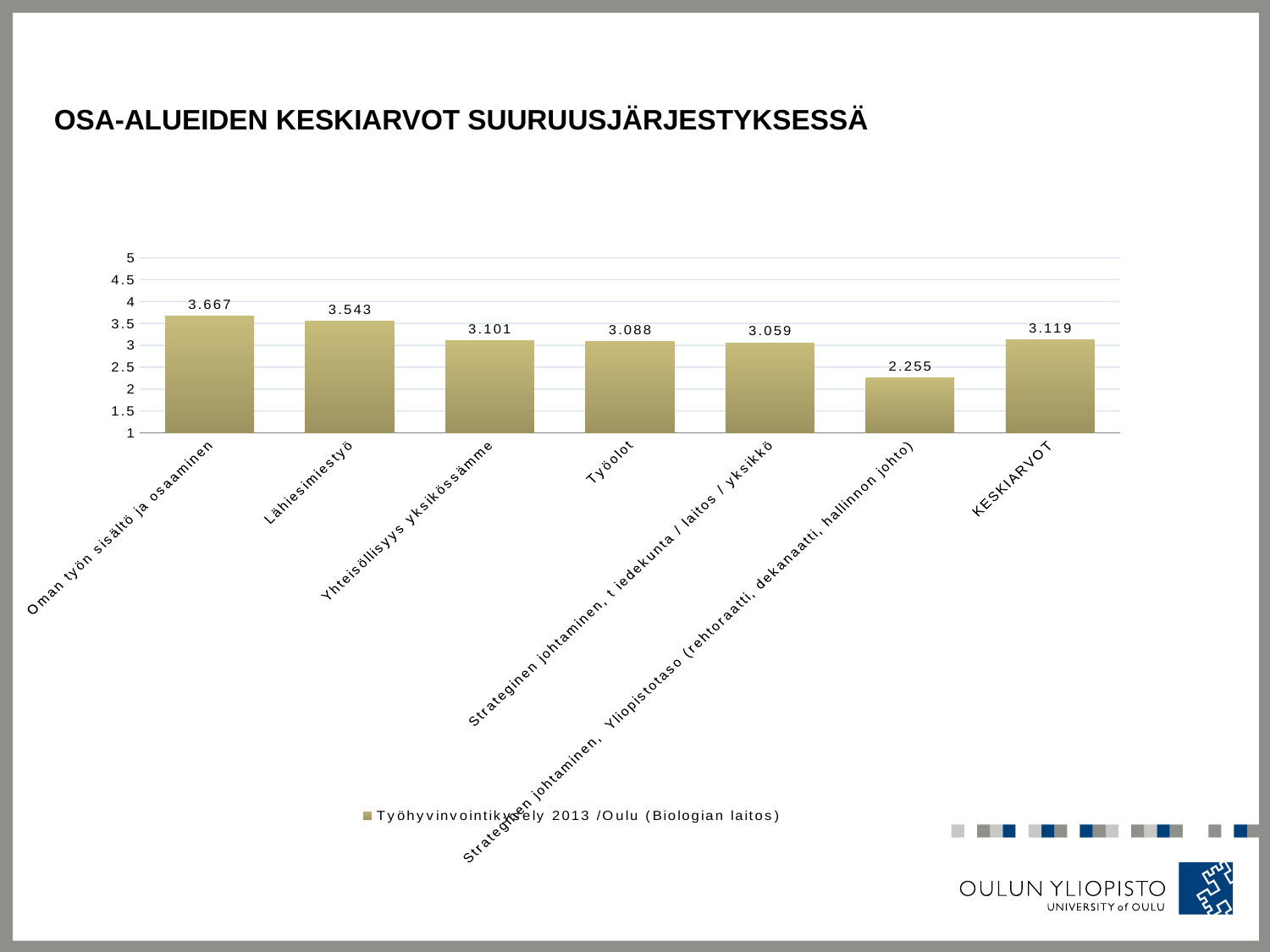
What is the value for Työolot? 3.088 Which is larger, the value for Lähiesimiestyö or the value for Työolot? Lähiesimiestyö How many bars are shown in the chart? 7 Is the value for Strateginen johtaminen, Yliopistotaso (rehtoraatti, dekanaatti, hallinnon johto) greater or less than 2.5? less Which category has the lowest value? Strateginen johtaminen, Yliopistotaso (rehtoraatti, dekanaatti, hallinnon johto) What is the difference between the values for Oman työn sisältö ja osaaminen and Lähiesimiestyö? 0.124 What is the value for Lähiesimiestyö? 3.543 What kind of chart is shown on the slide? bar chart What is the value for Oman työn sisältö ja osaaminen? 3.667 Which category has the highest value? Oman työn sisältö ja osaaminen What is the difference between the highest value (Oman työn sisältö ja osaaminen) and the lowest value (Strateginen johtaminen, Yliopistotaso)? 1.412 What is the value for KESKIARVOT? 3.119